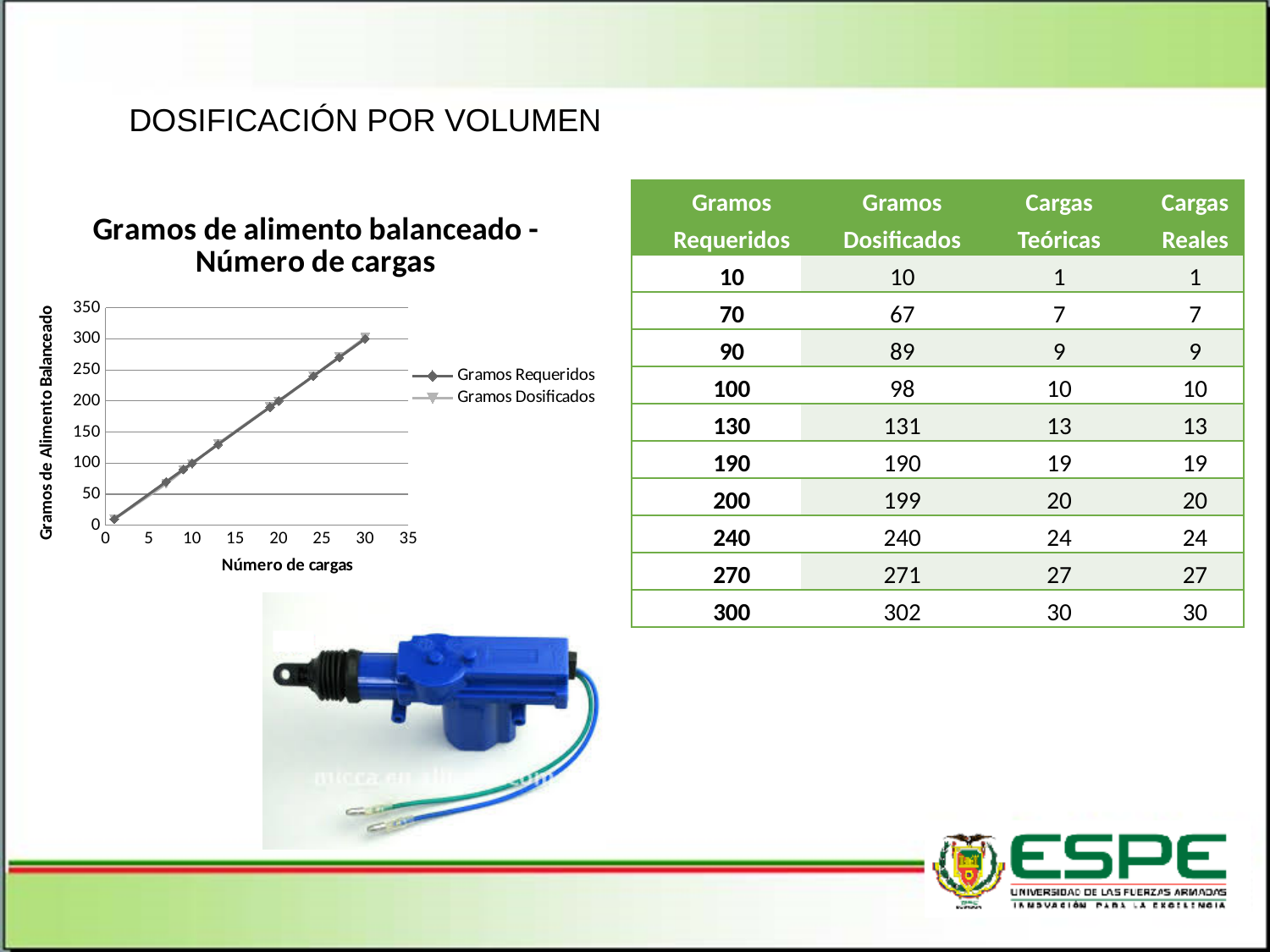
Is the value of Gramos Dosificados at 10 cargas greater or less than 150? less How many data points are plotted for each series in the chart? 10 What are the two series named in the chart legend? Gramos Requeridos and Gramos Dosificados According to the table, what is the Gramos Dosificados value for 300 Gramos Requeridos? 302 How many series does the chart legend list? 2 Is the value of Gramos Requeridos at 20 cargas greater or less than 150? greater What is the highest value shown on the chart's vertical axis? 350 Is the value of Gramos Dosificados at 13 cargas greater or less than 200? less What is the title of the chart? Gramos de alimento balanceado - Número de cargas Do the values in the chart rise or fall as Número de cargas increases? rise What kind of chart is shown on the slide? line chart